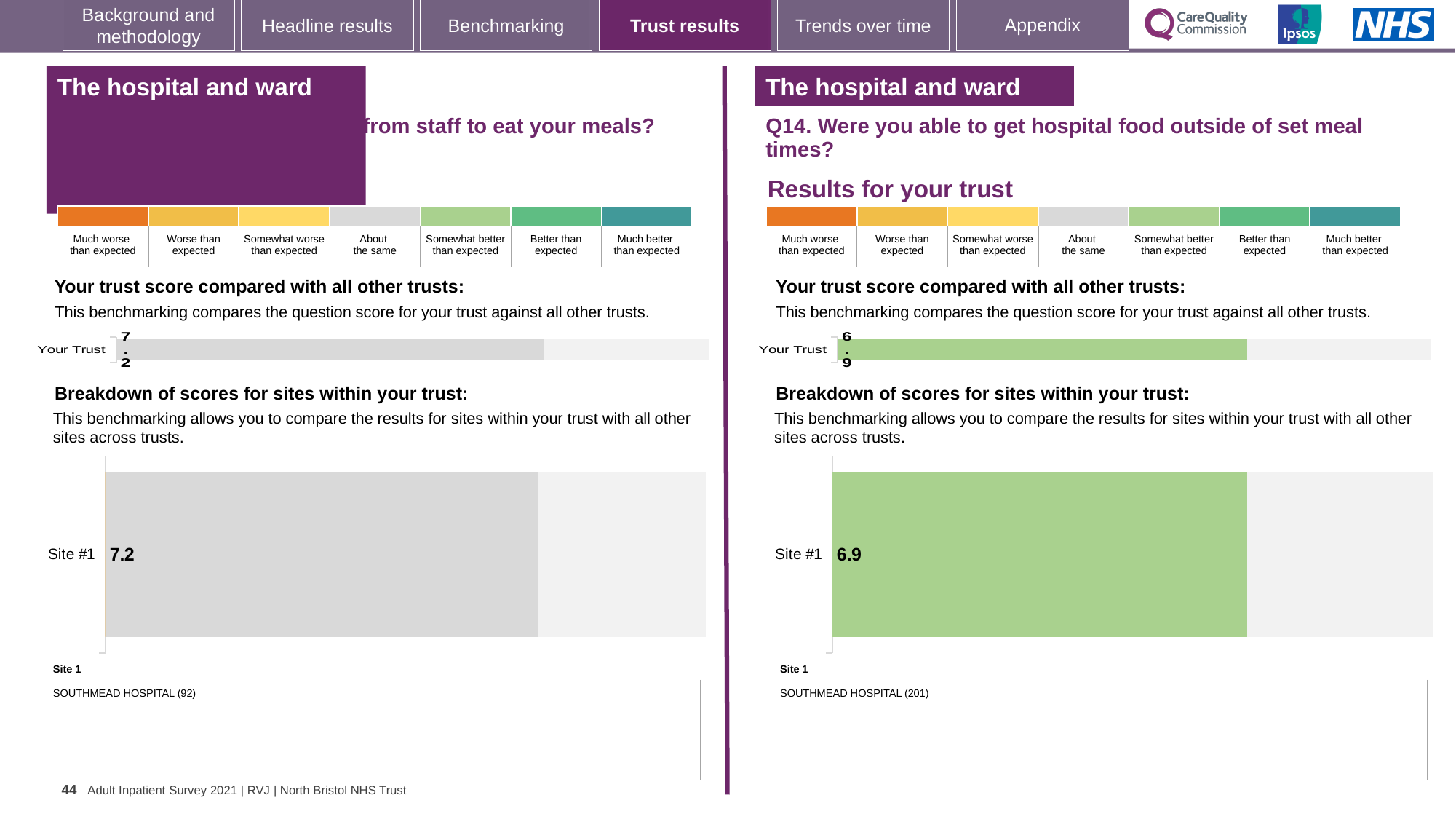
In the right 'Breakdown of scores for sites within your trust' chart (Q14), what is the score for Site #1? 6.9 On the left half of the slide, what is the 'Your Trust' score shown in the trust score bar chart? 7.2 Which hospital is listed as Site 1 beneath the right breakdown chart, and how many respondents are shown in brackets? SOUTHMEAD HOSPITAL (201) In the left 'Breakdown of scores for sites within your trust' chart, what is the score for Site #1? 7.2 How many sites are shown in the right 'Breakdown of scores for sites within your trust' chart? 1 What type of chart is used to show the Site #1 score on the right half of the slide? Bar chart According to the colour key, what does the grey colour of the Site #1 bar on the left half of the slide indicate? About the same On the right half of the slide (Q14), what is the 'Your Trust' score shown in the trust score bar chart? 6.9 Which is larger: the Site #1 score in the left breakdown chart or the Site #1 score in the right breakdown chart? The left chart (7.2) How many sites are shown in the left 'Breakdown of scores for sites within your trust' chart? 1 What is the difference between the Site #1 score in the left breakdown chart and the Site #1 score in the right breakdown chart? 0.3 According to the colour key, what does the light green colour of the Site #1 bar on the right half of the slide indicate? Somewhat better than expected